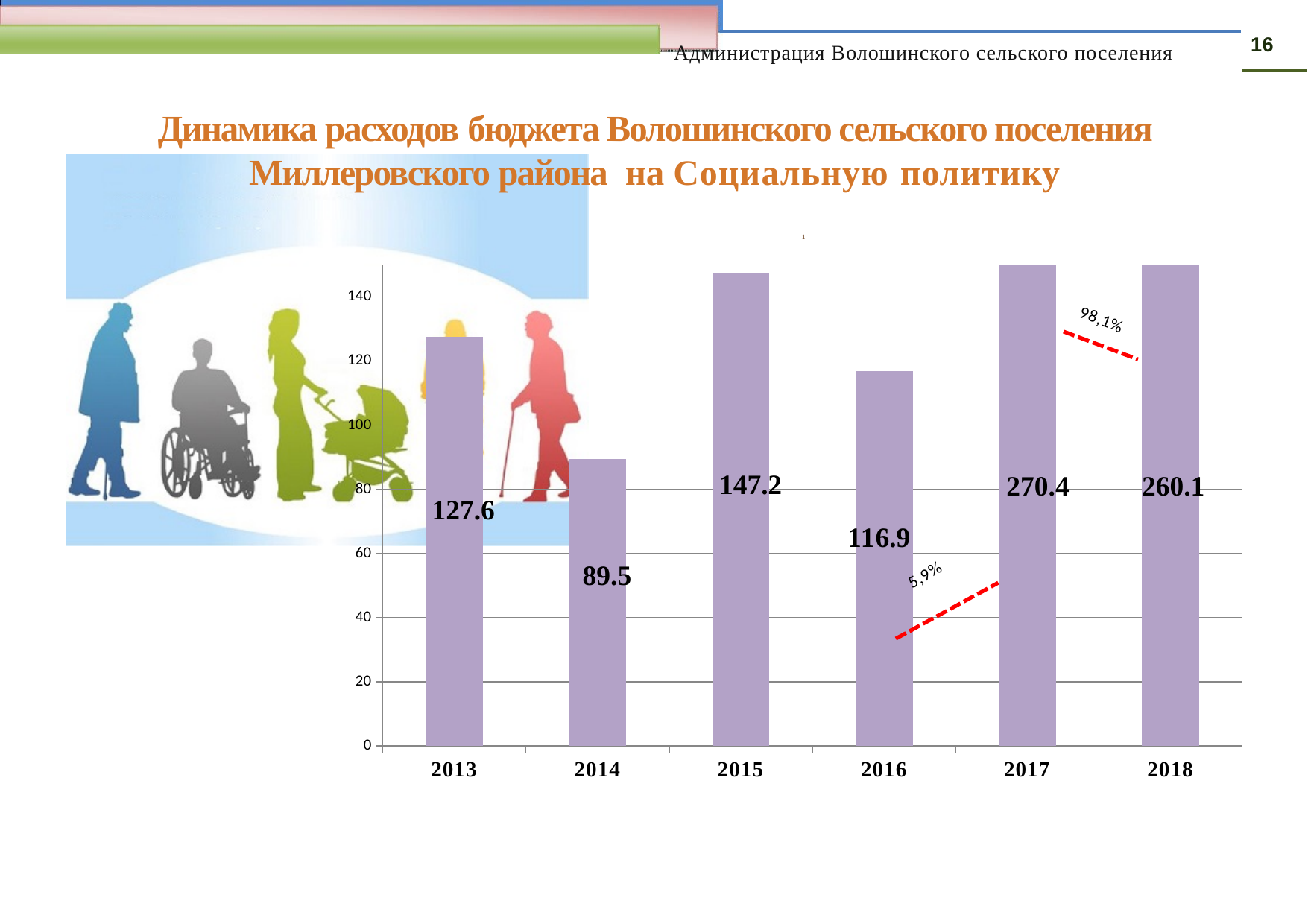
Which year has the lowest value? 2014 Which is larger, the value for 2015 or the value for 2016? 2015 What is the value for 2013? 127.6 Is the value for 2014 greater or less than 100? less What is the value for 2014? 89.5 Which year has the highest value? 2017 What is the difference between the values for 2017 and 2018? 10.3 How many years are shown on the x axis? 6 Does the value rise or fall from 2016 to 2017? rise What kind of chart is shown on the slide? bar chart What is the value for 2017? 270.4 What is the difference between the values for 2015 and 2013? 19.6